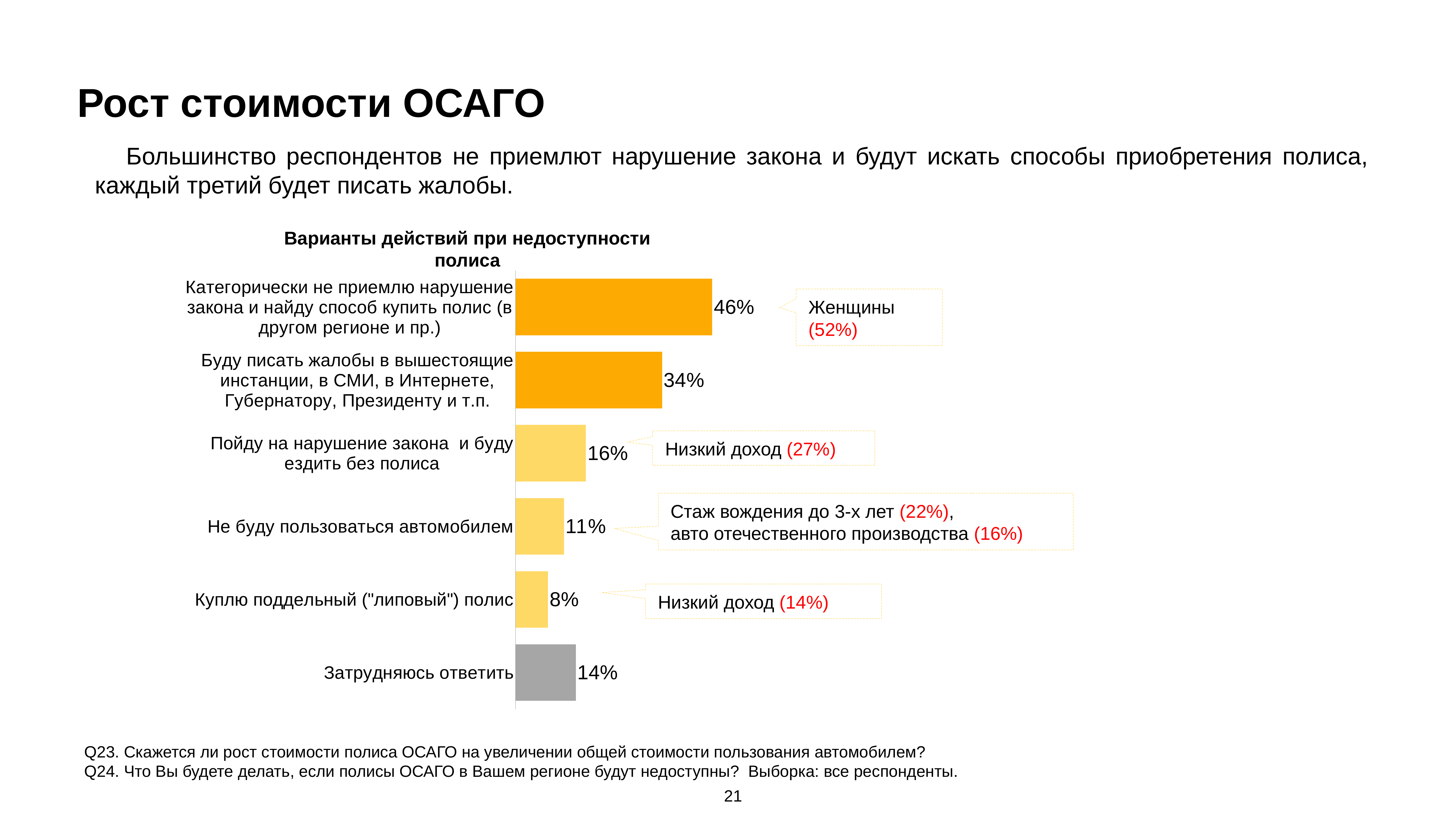
What is the value for "Пойду на нарушение закона и буду ездить без полиса"? 16% What kind of chart is shown on the slide? Bar chart What is the difference between the values for "Категорически не приемлю нарушение закона..." and "Буду писать жалобы..."? 12% What is the title of the chart? Варианты действий при недоступности полиса What is the value for "Буду писать жалобы в вышестоящие инстанции, в СМИ, в Интернете, Губернатору, Президенту и т.п."? 34% How many categories are shown in the chart? 6 Which category has the lowest value? Куплю поддельный ("липовый") полис What is the value for "Категорически не приемлю нарушение закона и найду способ купить полис (в другом регионе и пр.)"? 46% What is the value for "Куплю поддельный ("липовый") полис"? 8% What is the value for "Затрудняюсь ответить"? 14% Which is larger: the value for "Не буду пользоваться автомобилем" or for "Затрудняюсь ответить"? Затрудняюсь ответить Which category has the highest value? Категорически не приемлю нарушение закона и найду способ купить полис (в другом регионе и пр.)